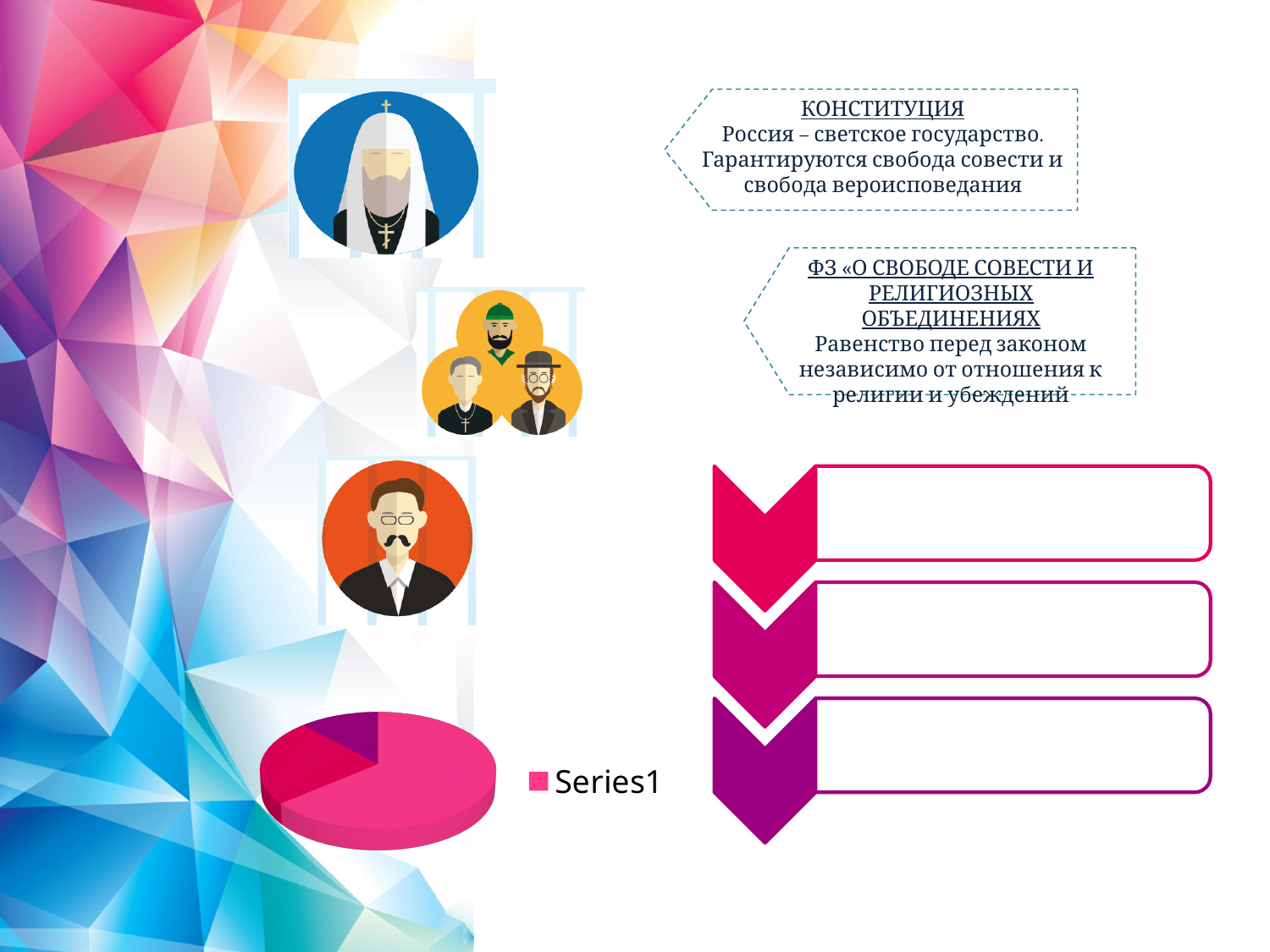
Is the bright pink slice of the pie chart more or less than half of the pie? more What is the name of the series shown in the pie chart's legend? Series1 Which slice of the pie chart is larger, the bright pink one or the dark magenta one? the bright pink one What kind of chart is shown at the bottom left of the slide? pie chart How many series does the legend of the pie chart list? 1